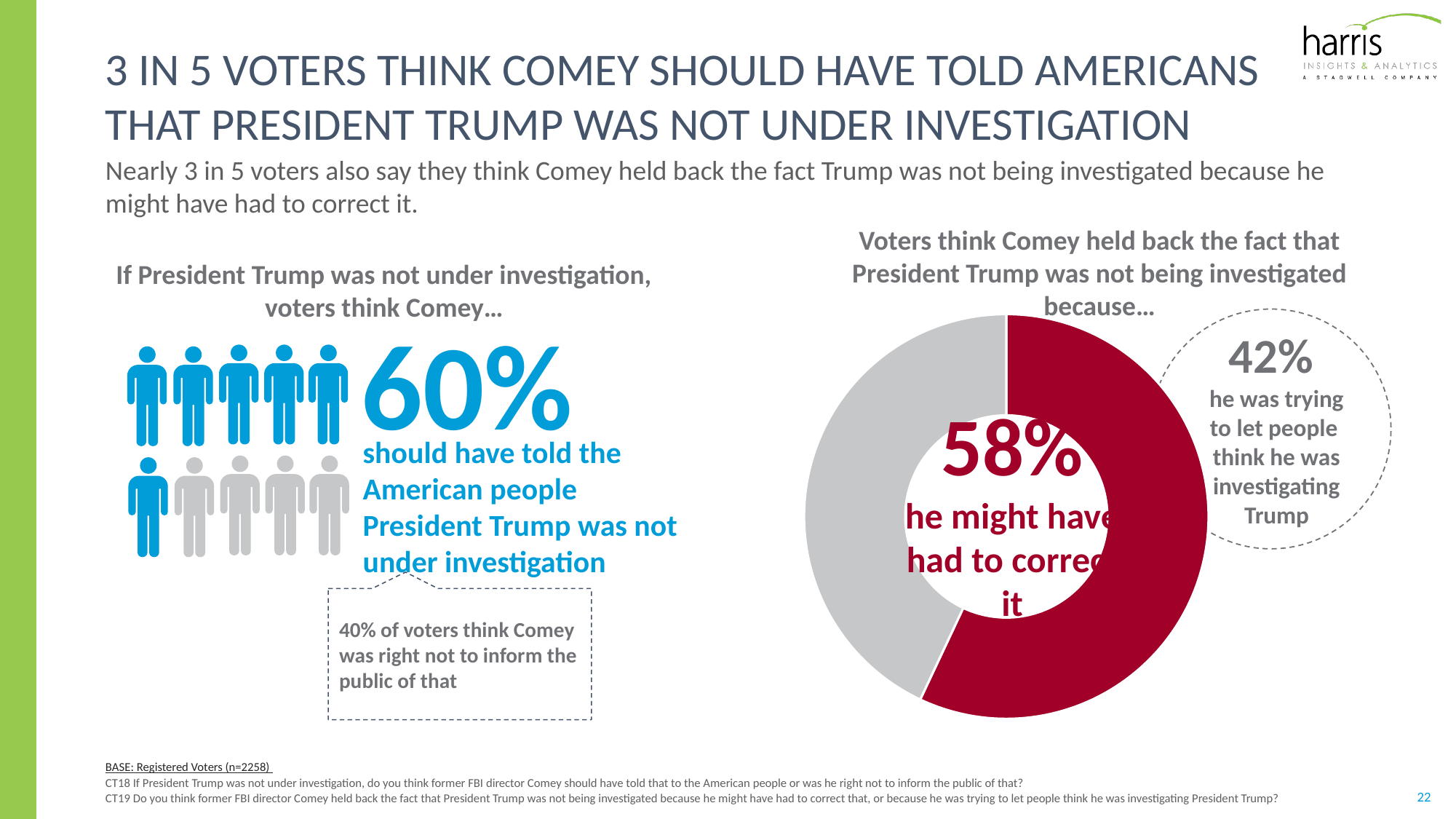
On the donut chart on the right, what share of voters think Comey was trying to let people think he was investigating Trump? 42% On the pictograph on the left, what percentage of voters think Comey was right not to inform the public? 40% On the donut chart on the right, which reason has the larger share: 'he might have had to correct it' or 'he was trying to let people think he was investigating Trump'? he might have had to correct it On the pictograph on the left, what percentage of voters think Comey should have told the American people President Trump was not under investigation? 60% On the pictograph on the left, how many person icons are shown in total? 10 What kind of chart is shown on the right side of the slide? Donut chart On the pictograph on the left, how many person icons are coloured blue? 6 On the donut chart on the right, what is the difference in percentage points between the 58% and 42% segments? 16 percentage points On the pictograph on the left, what is the difference in percentage points between voters who think Comey should have told the public (60%) and those who think he was right not to (40%)? 20 percentage points On the donut chart on the right, what colour is the 58% segment? Red On the donut chart on the right, how many segments are shown? 2 On the donut chart on the right, what share of voters think Comey held back the fact because he might have had to correct it? 58%